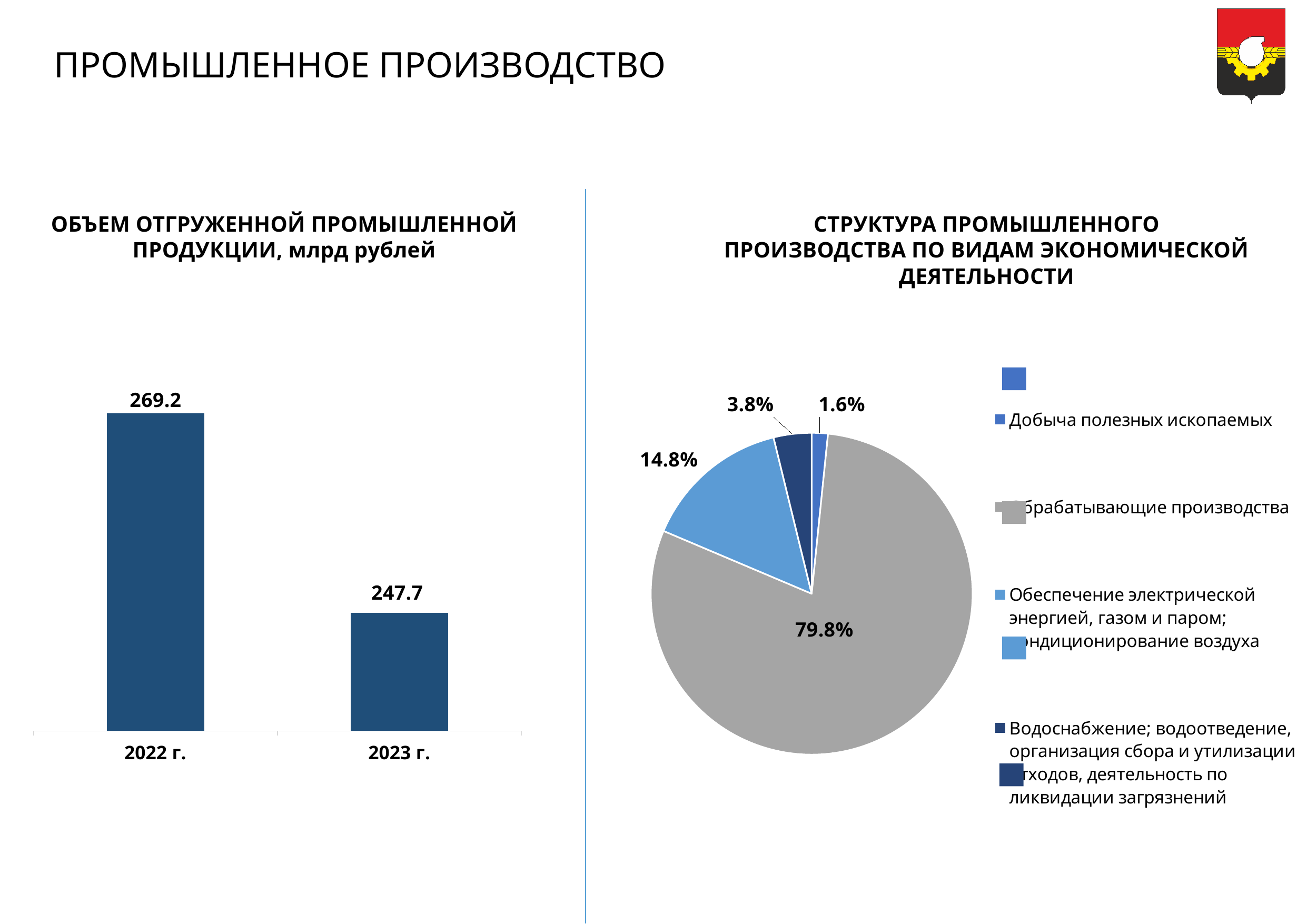
In the left chart 'ОБЪЕМ ОТГРУЖЕННОЙ ПРОМЫШЛЕННОЙ ПРОДУКЦИИ, млрд рублей', what is the value for 2023 г.? 247.7 In the left chart, do the values rise or fall from 2022 г. to 2023 г.? fall In the right pie chart, what share does 'Добыча полезных ископаемых' have? 1.6% In the left chart, which year has the higher value, 2022 г. or 2023 г.? 2022 г. How many categories are shown in the left bar chart? 2 In the right pie chart, which category has the smallest share? Добыча полезных ископаемых In the left chart, what is the difference between the 2022 г. and 2023 г. values? 21.5 In the right pie chart, what share does 'Обрабатывающие производства' have? 79.8% What kind of chart is the left chart on the slide? bar chart In the left chart 'ОБЪЕМ ОТГРУЖЕННОЙ ПРОМЫШЛЕННОЙ ПРОДУКЦИИ, млрд рублей', what is the value for 2022 г.? 269.2 How many slices does the right pie chart have? 4 What kind of chart is the right chart 'СТРУКТУРА ПРОМЫШЛЕННОГО ПРОИЗВОДСТВА ПО ВИДАМ ЭКОНОМИЧЕСКОЙ ДЕЯТЕЛЬНОСТИ'? pie chart